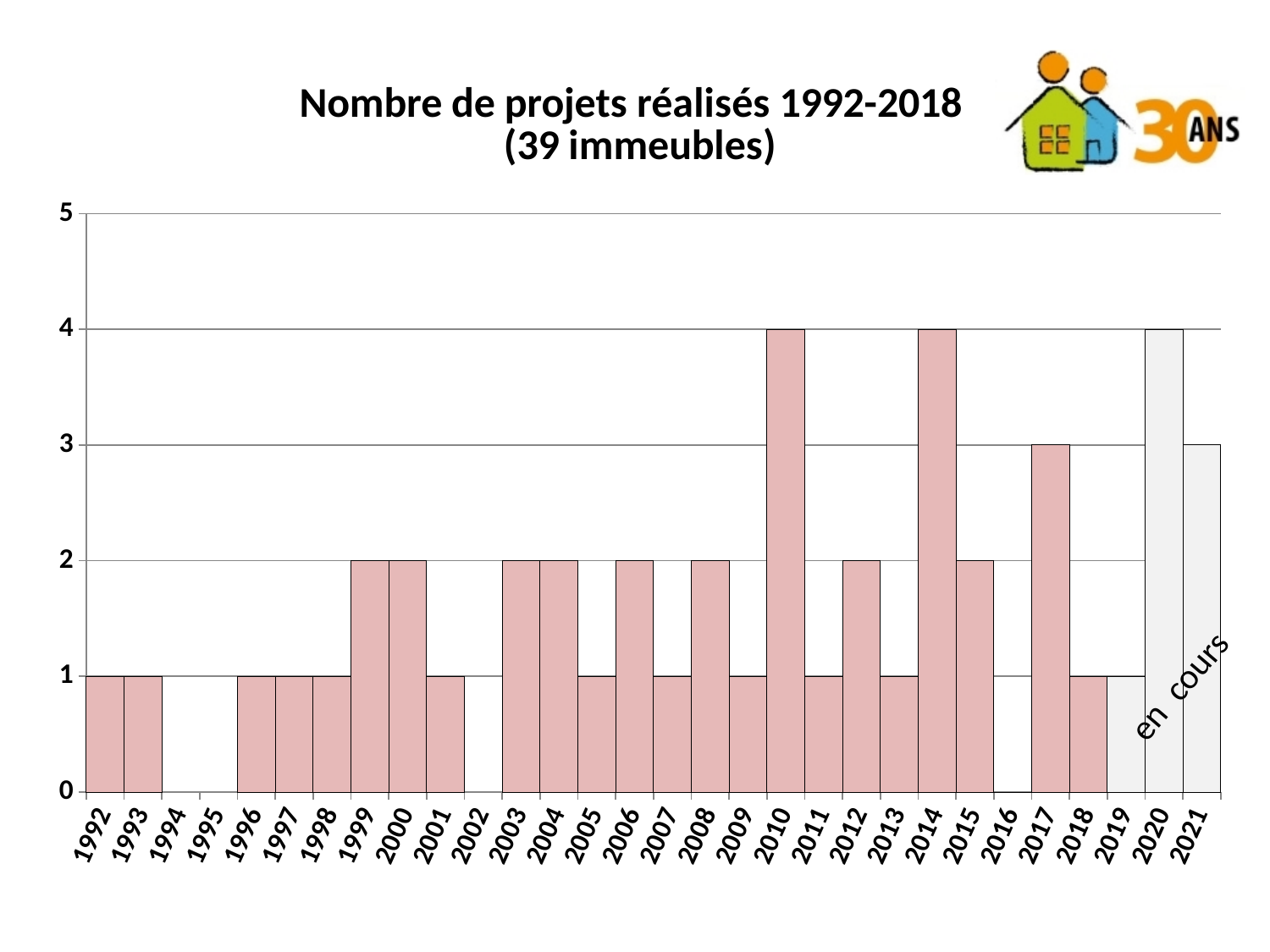
How many years are shown on the x axis? 30 Which year has the larger value, 2014 or 2015? 2014 What is the value for 1999? 2 What is the value for 2017? 3 What label is written on the grey bars for 2019-2021? en cours What is the value for 2021? 3 What is the value for 2016? 0 What is the value for 2010? 4 What is the highest value reached by any bar in the chart? 4 What is the difference between the values for 2017 and 2018? 2 What type of chart is shown on the slide? bar chart What is the title of the chart? Nombre de projets réalisés 1992-2018 (39 immeubles)